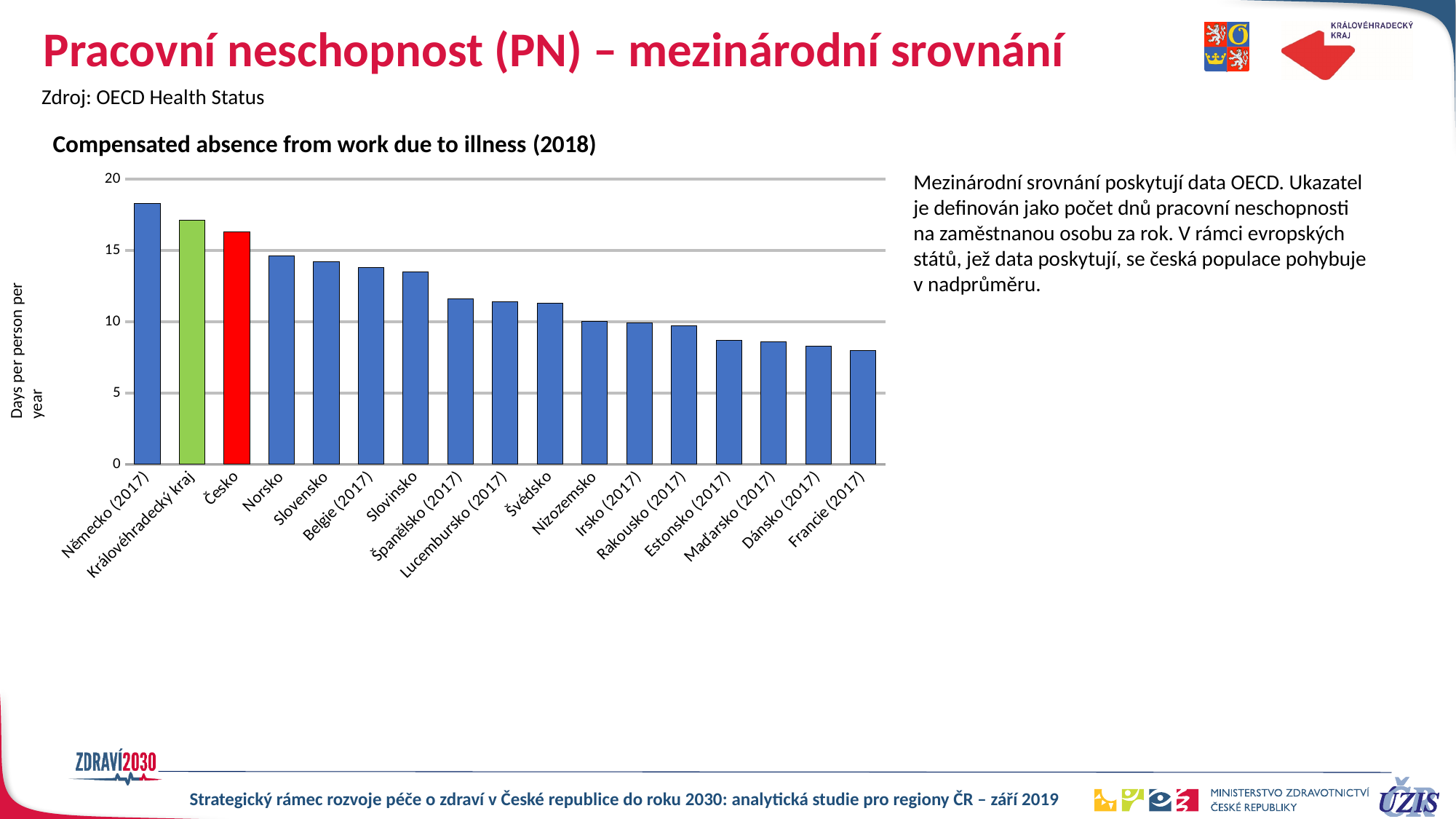
Which category has the lowest value in the chart? Francie (2017) What kind of chart is shown on the slide? bar chart Is the value for Norsko greater or less than 15? less Which has a larger value, Česko or Norsko? Česko How many categories are plotted in the chart? 17 Is the value for Francie (2017) greater or less than 10? less Is the value for Estonsko (2017) greater or less than 10? less What is the title of the chart? Compensated absence from work due to illness (2018) Which category has the highest value in the chart? Německo (2017) Do the values rise or fall from left to right along the x axis? fall